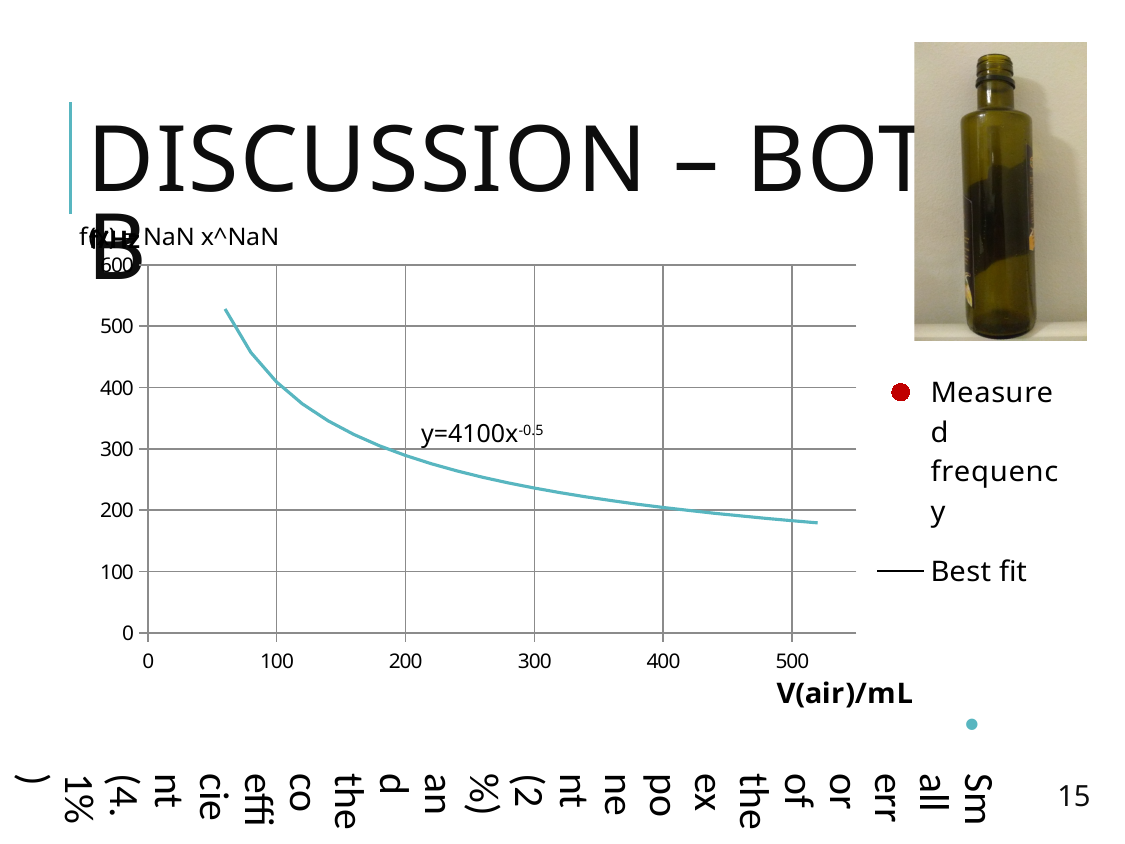
Is the value of the best fit curve at V(air) = 300 mL greater or less than 300? less What are the two entries in the chart's legend? Measured frequency and Best fit Is the value of the best fit curve at V(air) = 300 mL greater or less than 200? greater What equation is printed next to the best fit curve? y=4100x^-0.5 What is the highest tick value shown on the x axis? 500 Does the best fit curve rise or fall as V(air)/mL increases? fall How many series does the legend list? 2 What kind of chart is shown on the slide? line chart Is the value of the best fit curve at V(air) = 500 mL greater or less than 200? less What is the highest tick value shown on the y axis? 600 What is the label on the x axis of the chart? V(air)/mL